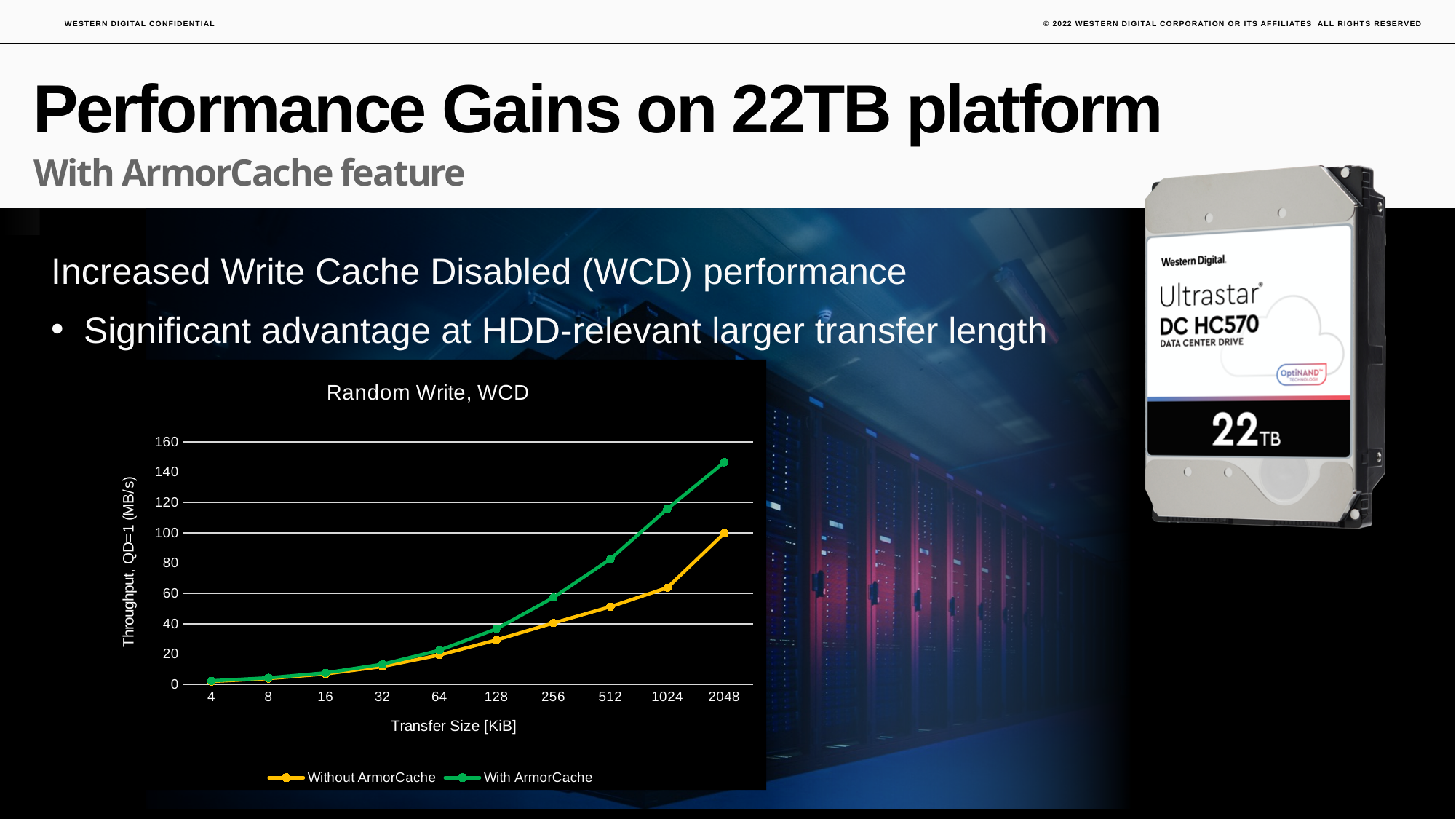
Is the value for With ArmorCache at 512 KiB greater or less than 60? greater At which transfer size does the With ArmorCache series reach its highest throughput? 2048 Is the value for Without ArmorCache at 256 KiB greater or less than 60? less Is the value for With ArmorCache at 2048 KiB greater or less than 140? greater How many series does the chart legend list? 2 At a transfer size of 2048 KiB, which series has the higher throughput, With ArmorCache or Without ArmorCache? With ArmorCache What is the label of the y axis? Throughput, QD=1 (MB/s) What is the title of the chart? Random Write, WCD Do the throughput values for With ArmorCache rise or fall as transfer size increases along the x axis? rise What kind of chart is shown on the slide? line chart How many transfer size points are plotted along the x axis? 10